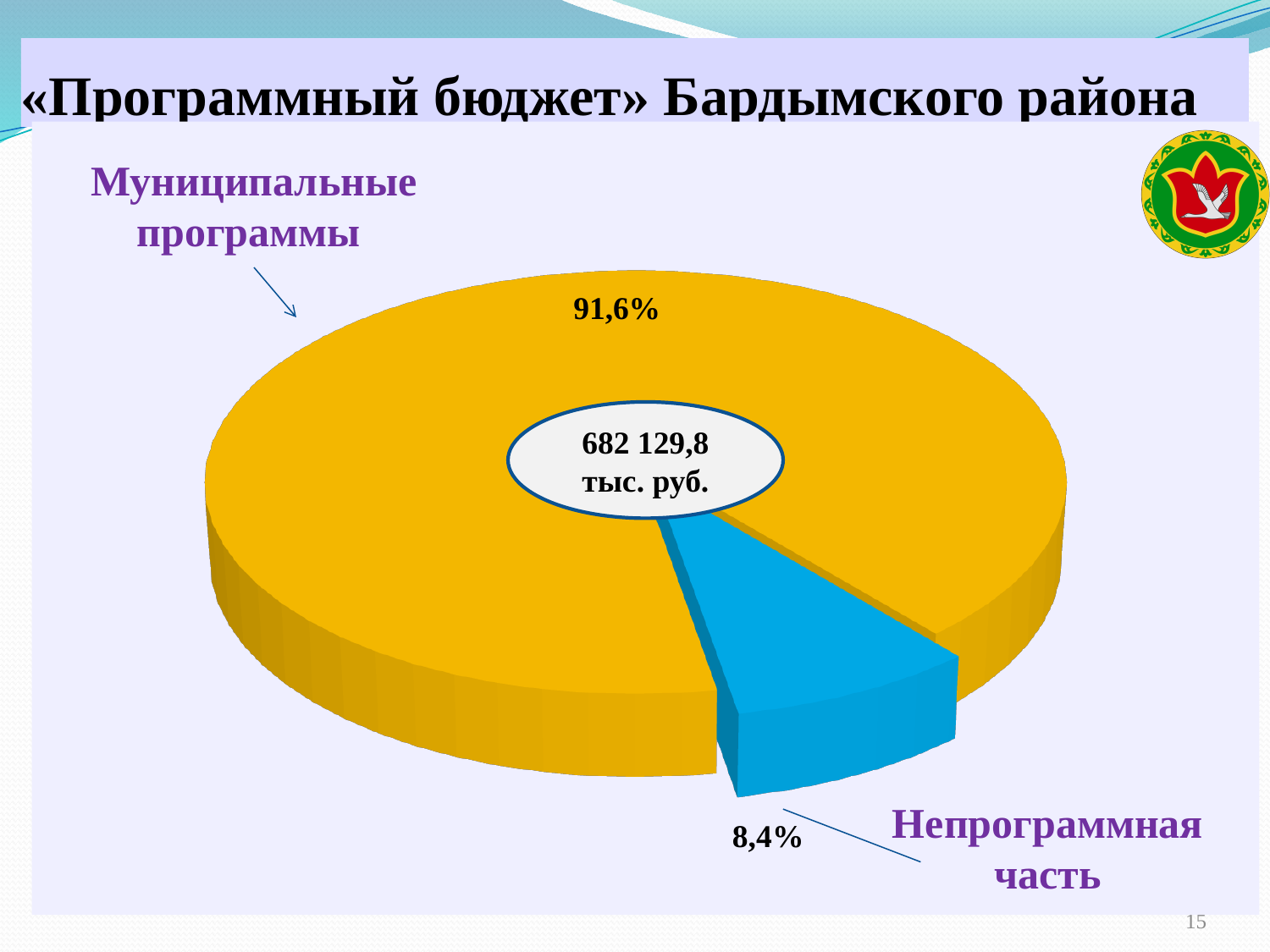
What is the difference in percentage points between the «Муниципальные программы» slice and the «Непрограммная часть» slice? 83,2 Which slice of the pie is the smallest? Непрограммная часть Which slice of the pie is the largest? Муниципальные программы Which is larger: the «Муниципальные программы» slice or the «Непрограммная часть» slice? Муниципальные программы What colour is the «Муниципальные программы» slice? yellow What share of the pie does «Непрограммная часть» take? 8,4% What total amount is printed in the centre of the pie chart? 682 129,8 тыс. руб. What share of the pie does «Муниципальные программы» take? 91,6% What colour is the «Непрограммная часть» slice? blue What kind of chart is shown on the slide? pie chart How many slices does the pie chart have? 2